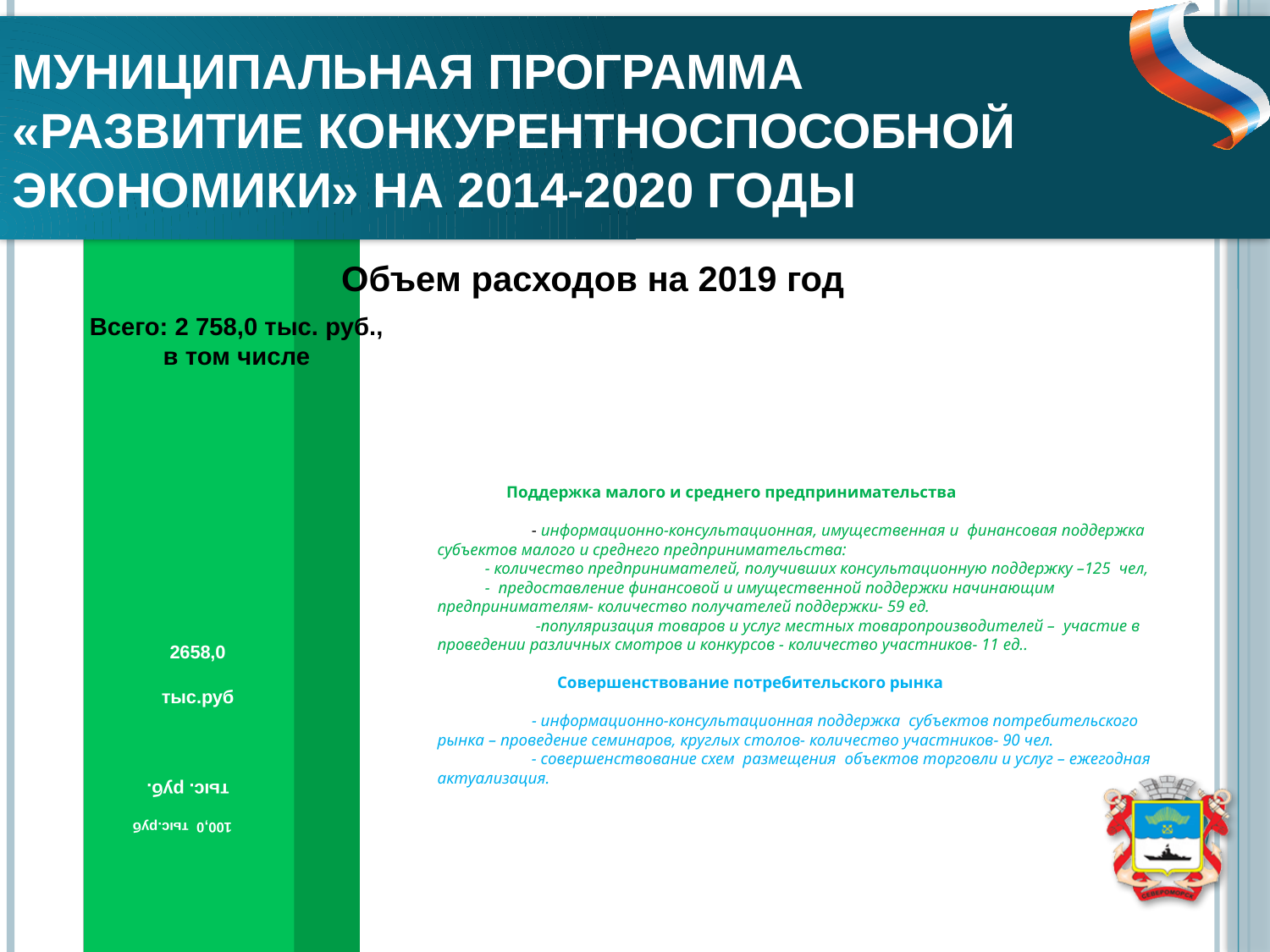
What is the difference between the two values labelled on the bar (2658,0 and 100,0)? 2558,0 тыс.руб What colour is the bar in the chart? green How many values are labelled on the bar? 2 What is the total of the two values labelled on the bar? 2 758,0 тыс. руб. What total amount is stated on the slide for 2019 expenditure (Всего)? 2 758,0 тыс. руб. What kind of chart is shown on the left of the slide? bar chart What is the smaller value labelled on the bar? 100,0 тыс.руб Which of the two labelled values on the bar is larger, 2658,0 or 100,0? 2658,0 What is the title shown above the chart on the slide? Объем расходов на 2019 год What is the larger value labelled on the bar? 2658,0 тыс.руб